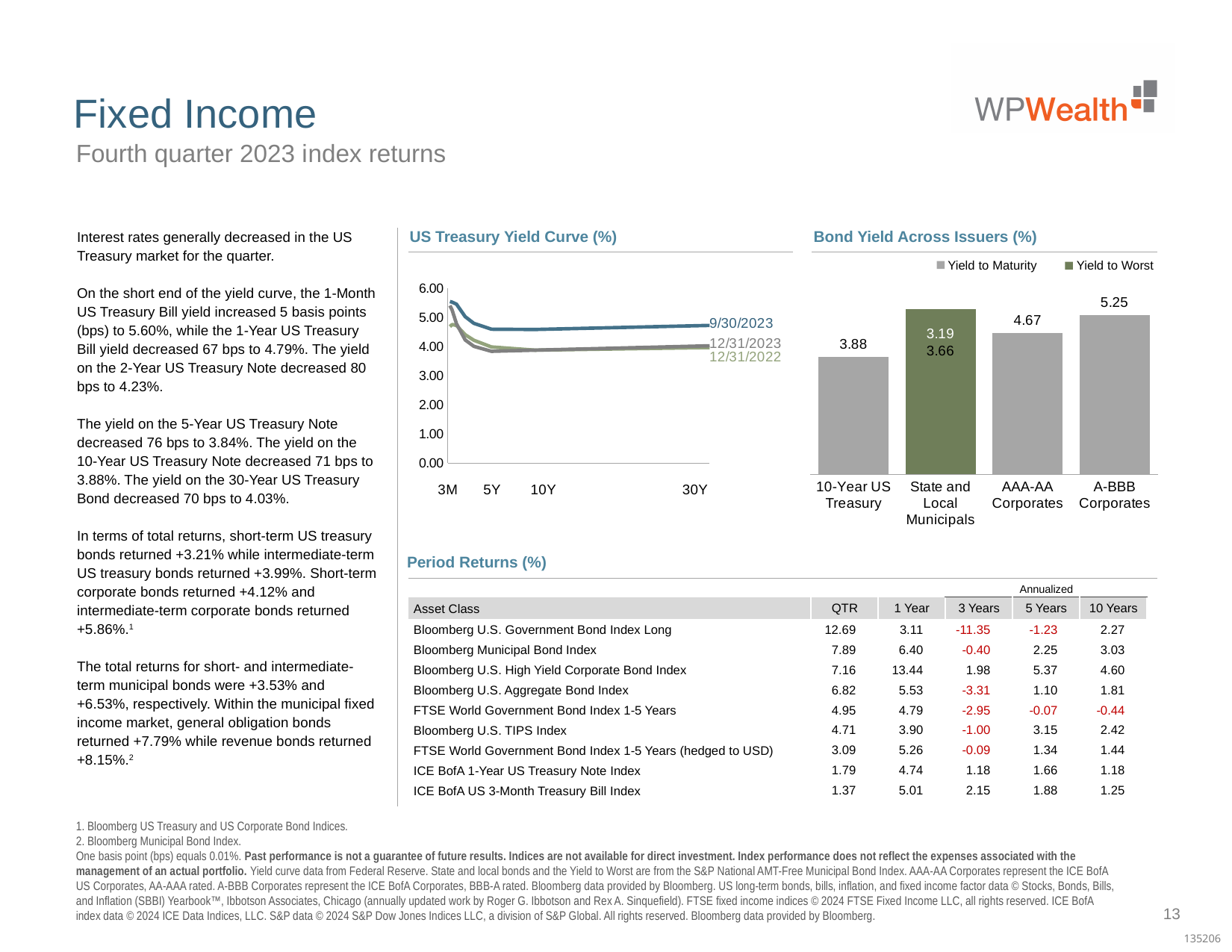
How many series are plotted in the US Treasury Yield Curve (%) chart? 3 In the Bond Yield Across Issuers (%) chart, what is the difference between A-BBB Corporates and 10-Year US Treasury? 1.37 What kind of chart is the Bond Yield Across Issuers (%) chart? Bar chart How many categories are shown on the x axis of the Bond Yield Across Issuers (%) chart? 4 In the Bond Yield Across Issuers (%) chart, what is the value for AAA-AA Corporates? 4.67 In the US Treasury Yield Curve (%) chart, is the 9/30/2023 value at 30Y greater or less than 4.00? greater In the Bond Yield Across Issuers (%) chart, what is the value for 10-Year US Treasury? 3.88 In the Bond Yield Across Issuers (%) chart, what is the value for A-BBB Corporates? 5.25 In the Bond Yield Across Issuers (%) chart, which is larger: AAA-AA Corporates or A-BBB Corporates? A-BBB Corporates In the US Treasury Yield Curve (%) chart, does the 9/30/2023 line rise or fall from 3M to 5Y? Fall What kind of chart is the US Treasury Yield Curve (%) chart? Line chart What are the two legend entries in the Bond Yield Across Issuers (%) chart? Yield to Maturity and Yield to Worst